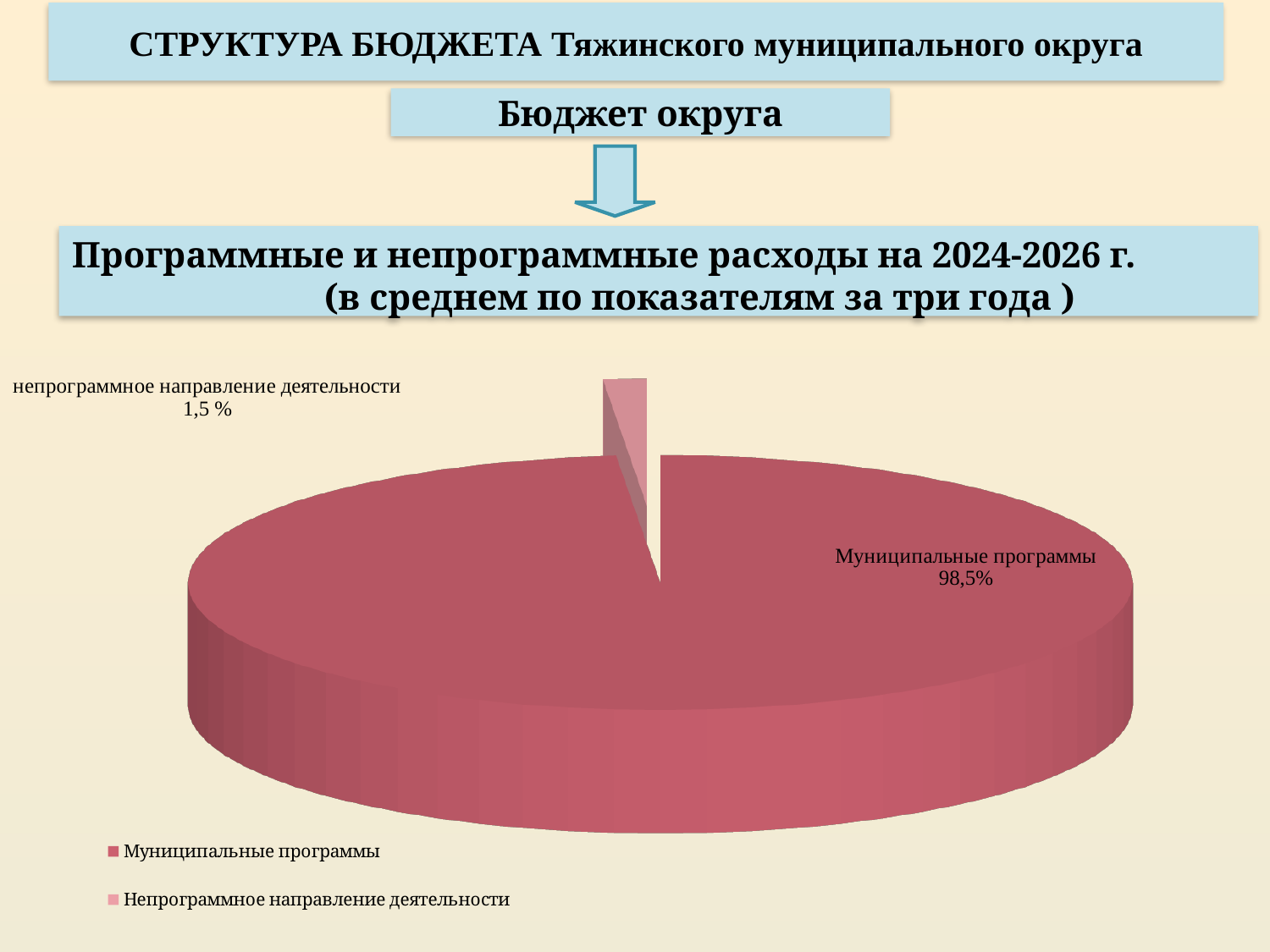
What is the total of the two percentages shown on the pie chart? 100% Which legend entry is shown in the lighter pink colour? Непрограммное направление деятельности How many entries does the legend of the pie chart list? 2 Which slice of the pie chart is the smallest? Непрограммное направление деятельности Which slice of the pie chart is the largest? Муниципальные программы What share of the pie chart is labelled for непрограммное направление деятельности? 1,5 % Which is larger: the share for Муниципальные программы or the share for непрограммное направление деятельности? Муниципальные программы What kind of chart is shown on the slide? Pie chart What share of the pie chart is labelled for Муниципальные программы? 98,5% What is the difference in percentage points between the Муниципальные программы slice and the непрограммное направление деятельности slice? 97 percentage points What period does the chart heading say the programme and non-programme expenditures cover? 2024-2026 г. How many slices does the pie chart have? 2